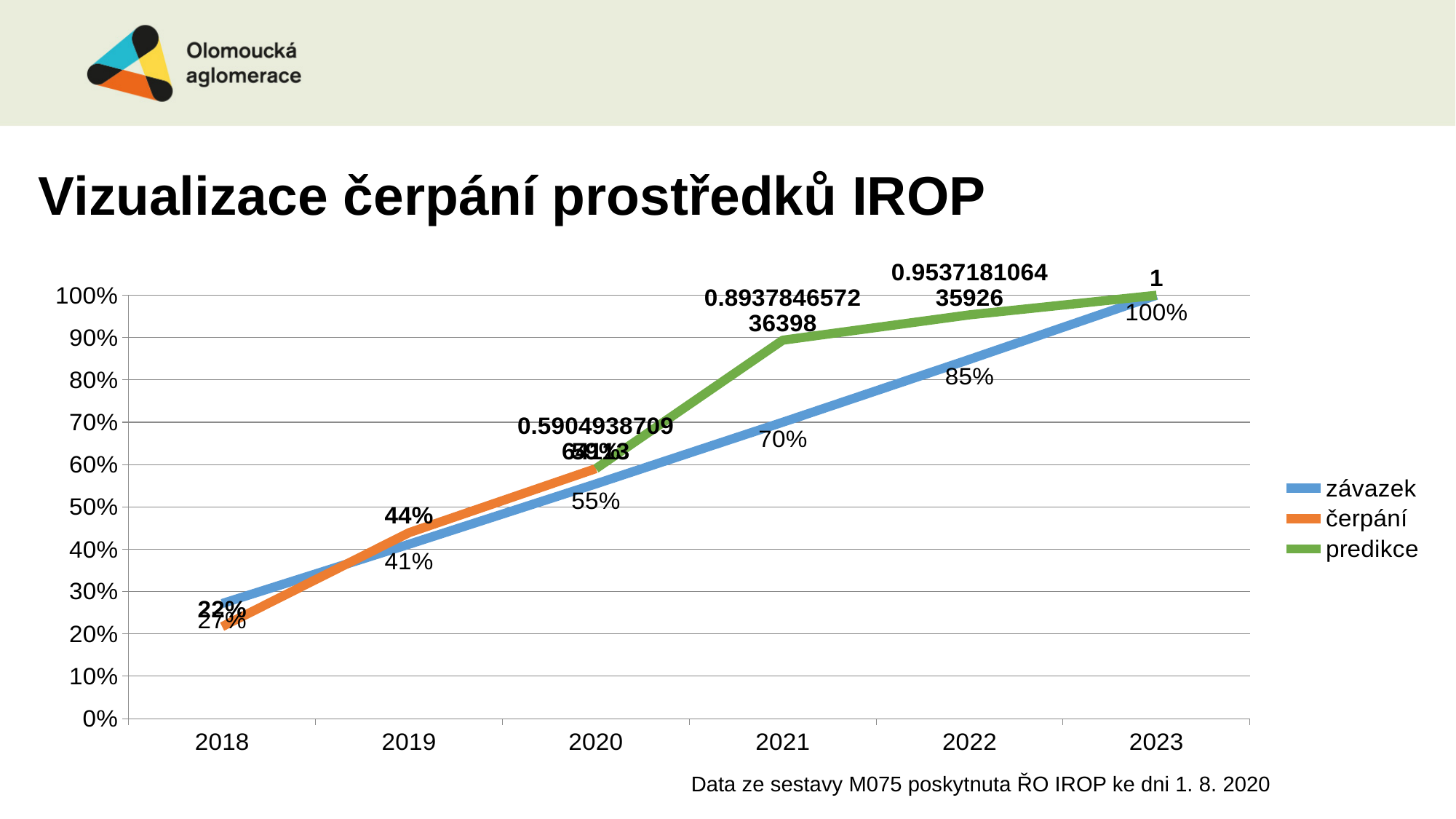
What is the value of závazek in 2023? 100% Does the závazek series rise or fall from 2018 to 2023? rise What is the value of čerpání in 2018? 22% What is the difference between závazek in 2022 and závazek in 2021? 15% What is the value of čerpání in 2019? 44% What kind of chart is shown on the slide? line chart What is the value of závazek in 2021? 70% Is the value of predikce in 2021 greater or less than 80%? greater In 2019, which is larger: čerpání or závazek? čerpání How many series does the legend list? 3 What is the value of predikce in 2023? 1 How many years are shown on the x axis? 6